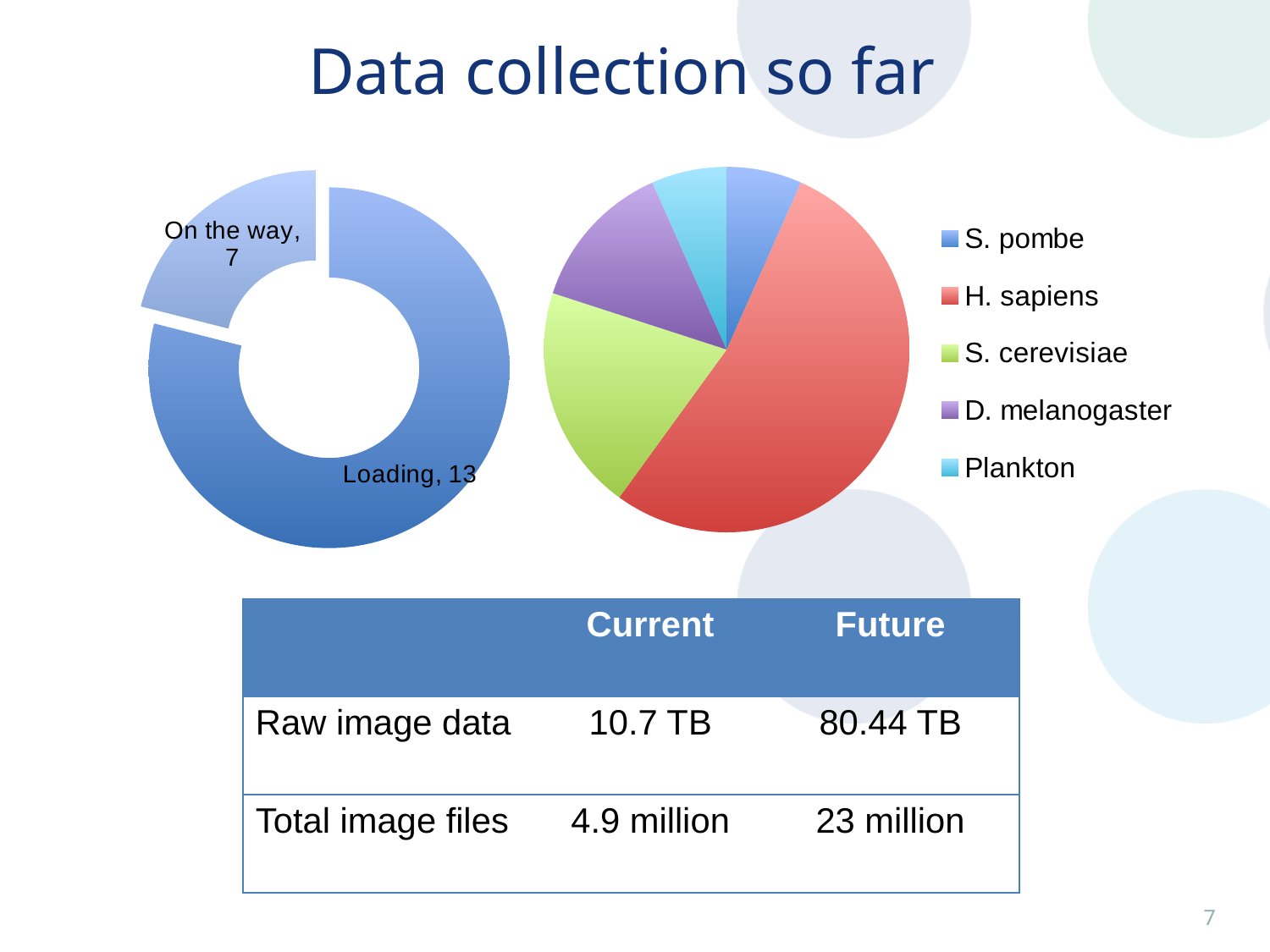
In the left doughnut chart, what is the value for Loading? 13 In the right pie chart, which category has the largest slice? H. sapiens In the left doughnut chart, what is the total of Loading and On the way? 20 How many categories does the left doughnut chart show? 2 In the left doughnut chart, what is the difference between Loading and On the way? 6 In the left doughnut chart, which category has the smaller value? On the way What kind of chart is the chart on the right of the slide? Pie chart In the left doughnut chart, which category has the larger value? Loading In the left doughnut chart, what is the value for On the way? 7 In the left doughnut chart, what share of the total does Loading represent? 65% In the right pie chart, which slice is larger, S. cerevisiae or Plankton? S. cerevisiae How many entries does the legend of the right pie chart list? 5